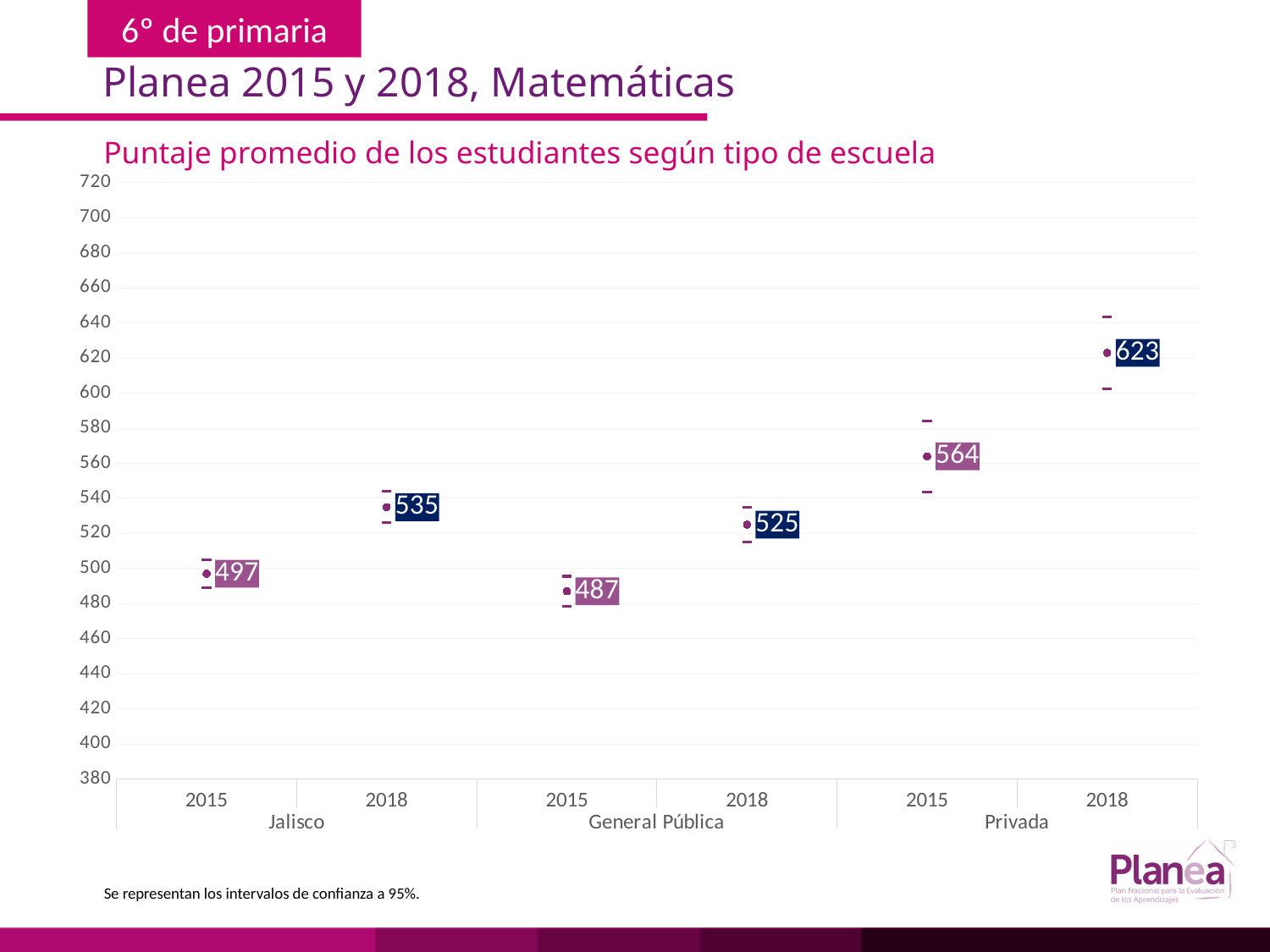
Which group and year has the highest average score? Privada 2018 What is the average score for Jalisco in 2018? 535 What is the difference between the Privada 2018 score and the Privada 2015 score? 59 Which group and year has the lowest average score? General Pública 2015 How many data points are plotted on the chart? 6 Which is larger, the Jalisco 2018 score or the General Pública 2018 score? Jalisco 2018 By how many points did the General Pública score increase from 2015 to 2018? 38 Is the Privada 2015 score greater or less than 600? less What is the average score for Jalisco in 2015? 497 What is the title of the chart? Puntaje promedio de los estudiantes según tipo de escuela What is the average score for Privada schools in 2018? 623 What is the average score for General Pública schools in 2015? 487